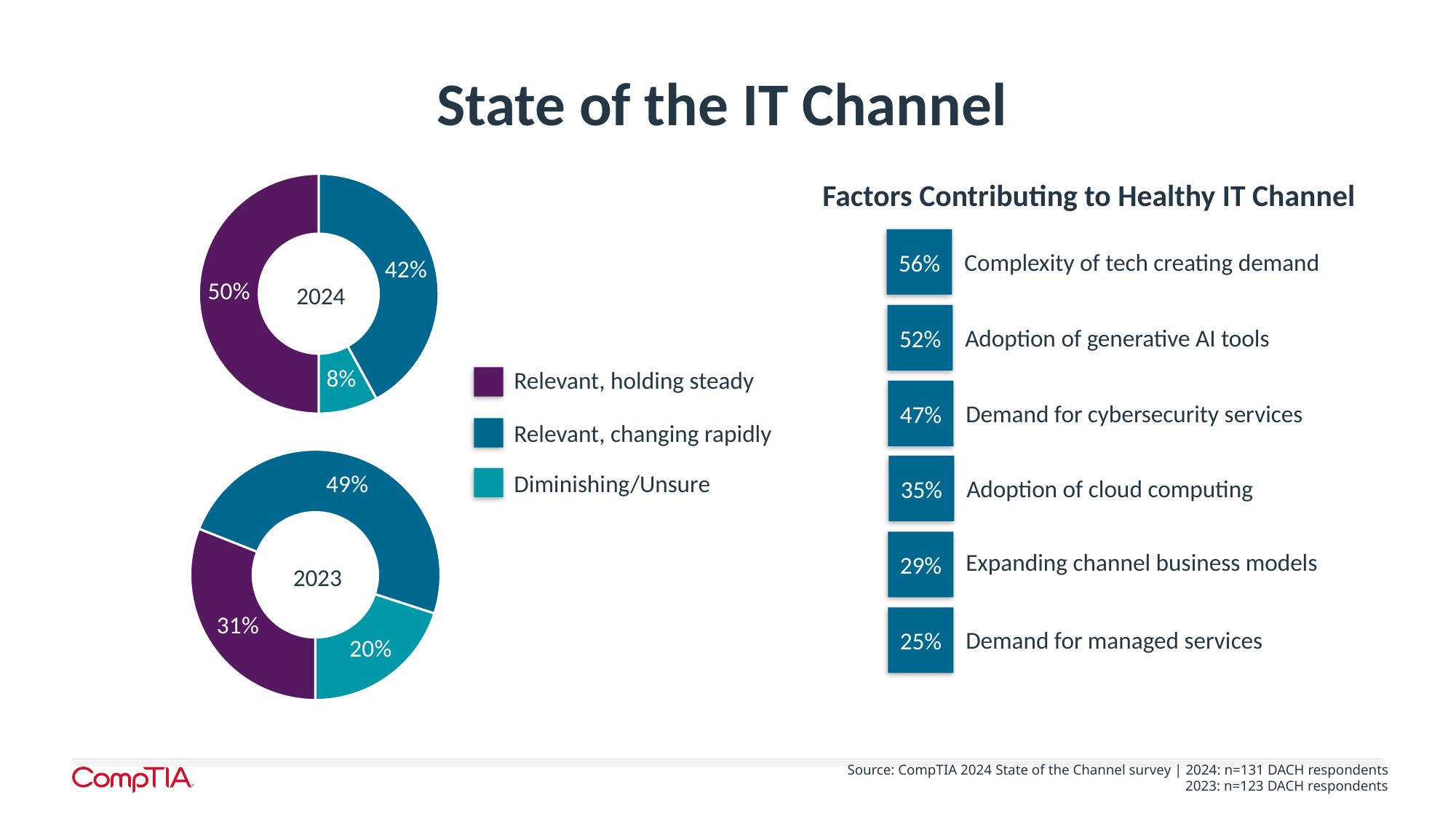
In the 'Factors Contributing to Healthy IT Channel' list, what percentage is shown for 'Adoption of generative AI tools'? 52% Is the 'Diminishing/Unsure' share larger in the 2024 donut chart or the 2023 donut chart? 2023 Which colour represents 'Relevant, holding steady' in the donut charts? Purple In the 'Factors Contributing to Healthy IT Channel' list, which factor has the highest percentage? Complexity of tech creating demand What is the difference between the 'Relevant, holding steady' share in 2024 and in 2023? 19 percentage points In the 2024 donut chart, what share of respondents said 'Relevant, changing rapidly'? 42% What type of chart is used to show the 2024 and 2023 results on the left of the slide? Donut (pie) chart How many categories does the legend for the donut charts list? 3 In the 2023 donut chart, which category has the largest share? Relevant, changing rapidly In the 2023 donut chart, what share of respondents said 'Diminishing/Unsure'? 20% In the 2024 donut chart, what share of respondents said the IT channel is 'Relevant, holding steady'? 50% In the 2024 donut chart, which category has the smallest share? Diminishing/Unsure